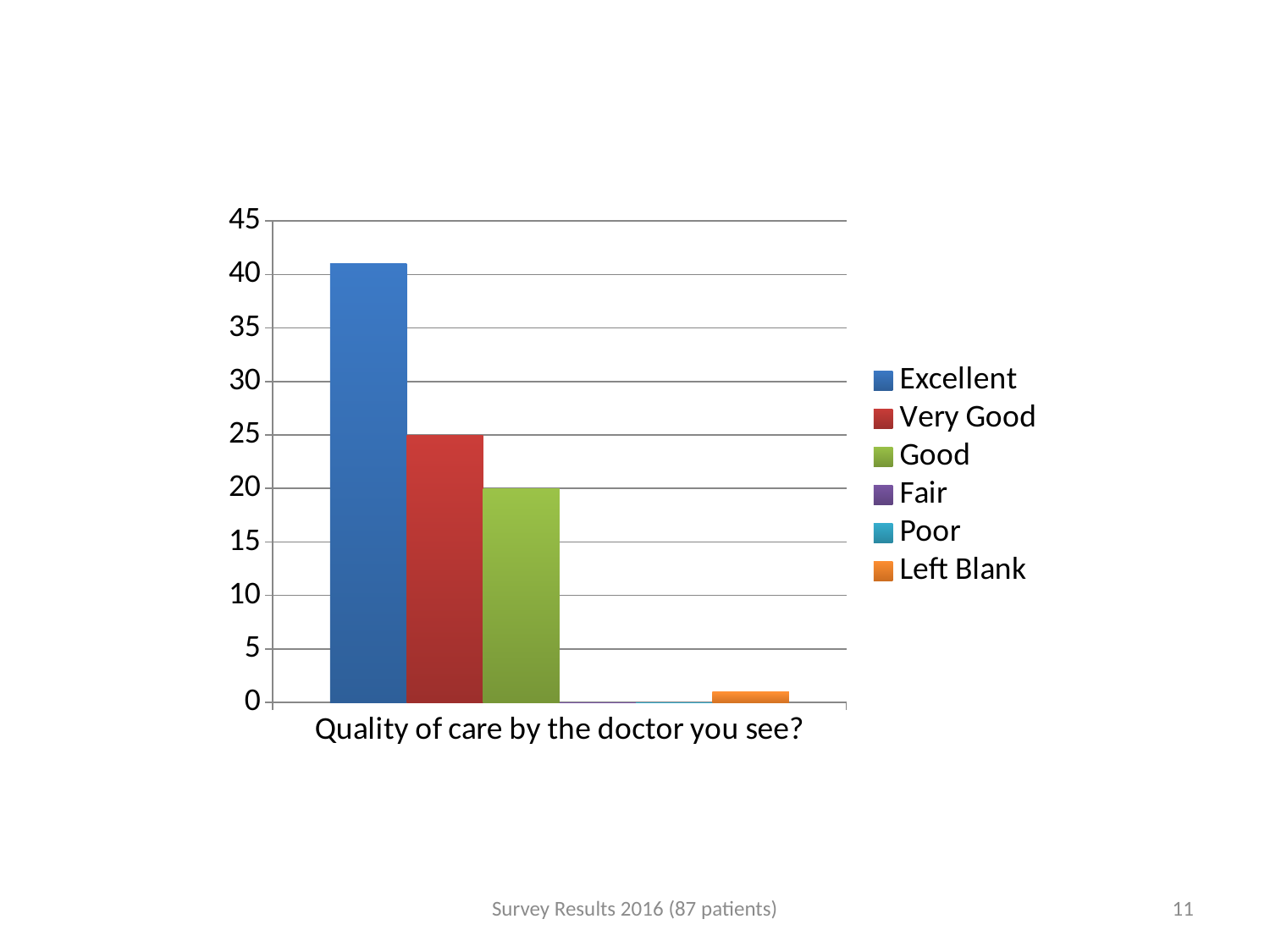
Is the value for Left Blank greater or less than 5? less Which is larger, the value for Good or the value for Left Blank? Good Which series has the highest value? Excellent What is the label shown on the x axis of the chart? Quality of care by the doctor you see? What colour is the bar for Left Blank? orange Which is larger, the value for Excellent or the value for Very Good? Excellent How many series does the legend list? 6 What is the difference between the values for Very Good and Good? 5 What is the value for Very Good? 25 What is the value for Good? 20 Is the value for Excellent greater or less than 40? greater What type of chart is shown on the slide? bar chart